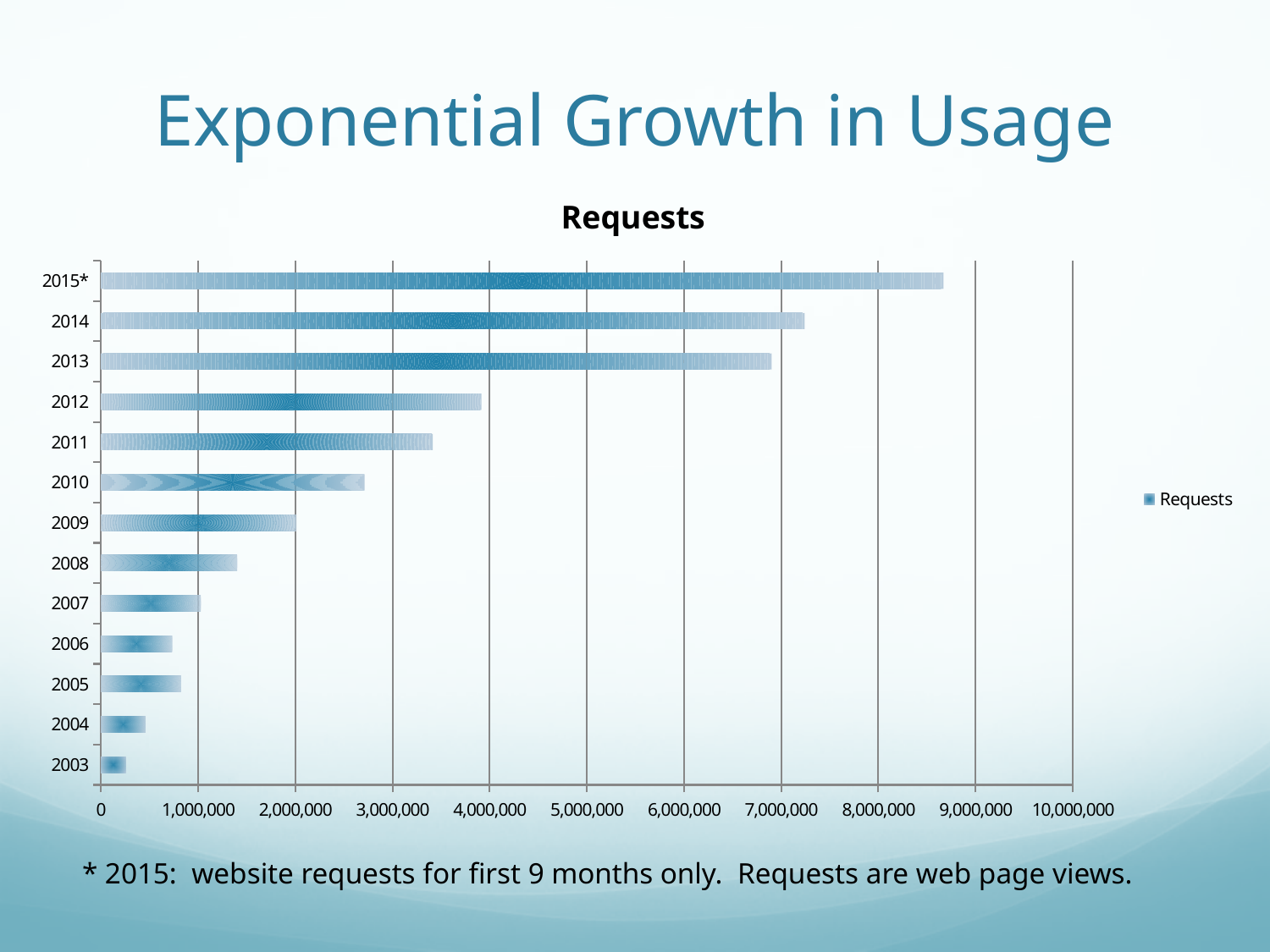
Do the requests generally rise or fall from 2003 to 2015*? rise What is the title of the chart? Requests Which year has more requests, 2012 or 2011? 2012 What kind of chart is shown on the slide? bar chart How many series does the legend list? 1 Which year has the highest number of requests? 2015* Is the value for 2008 greater or less than 1,000,000? greater Is the value for 2010 greater or less than 3,000,000? less Is the value for 2011 greater or less than 3,000,000? greater Which year has the lowest number of requests? 2003 How many years (categories) are plotted on the chart? 13